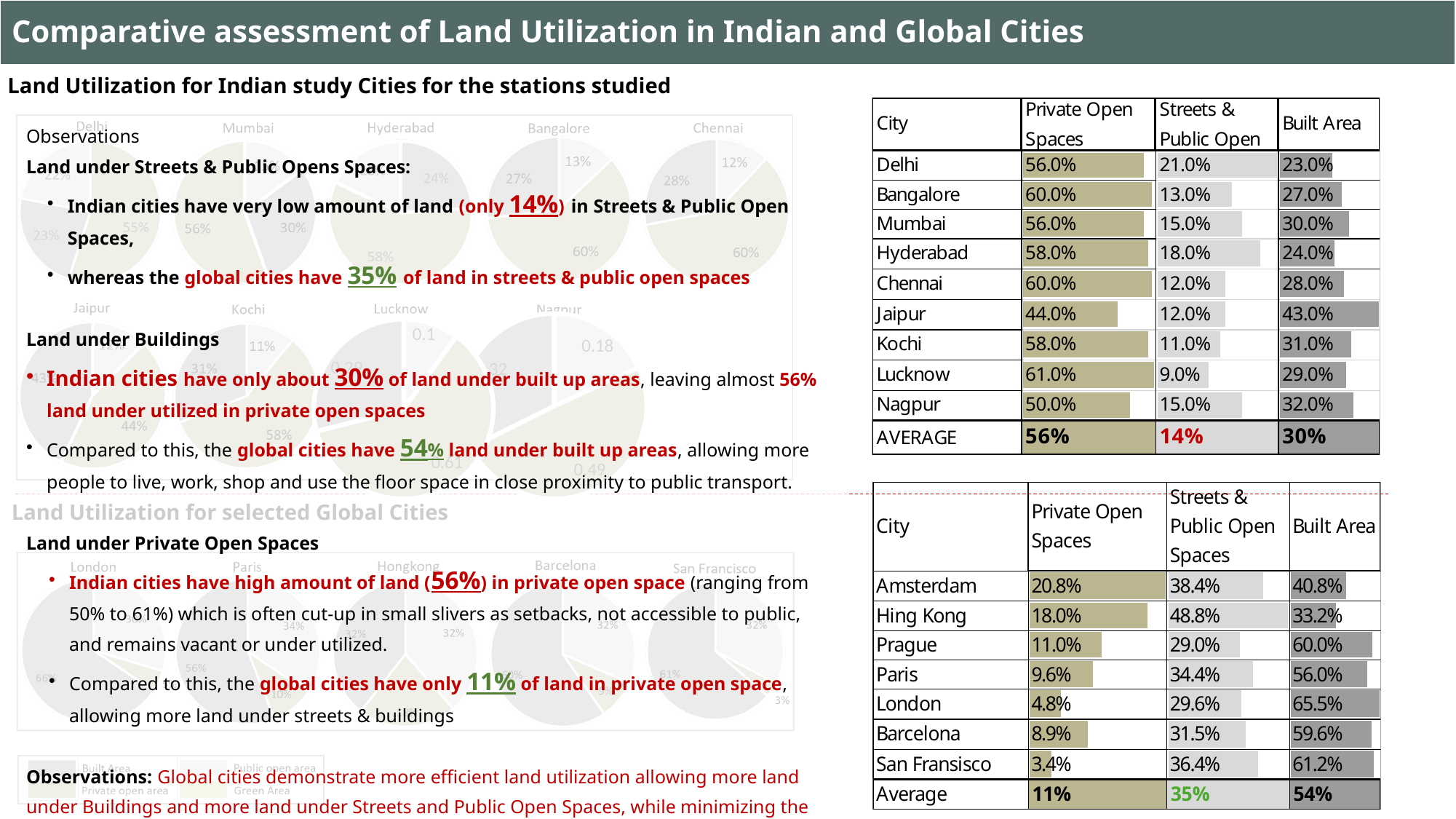
In the global cities table, which city has the highest Streets & Public Open Spaces value? Hing Kong In the Indian cities table, which city has the lowest Streets & Public Open value? Lucknow In the Indian cities table, what is the Private Open Spaces value for Jaipur? 44.0% How many individual cities (excluding the average row) are listed in the Indian cities table? 9 In the Indian cities table, which has a larger Private Open Spaces value, Kochi or Nagpur? Kochi In the Indian cities table, what is the AVERAGE value for Streets & Public Open? 14% In the Indian cities table, which city has the highest Built Area? Jaipur What kind of charts are shown faded behind the text on the left side of the slide? Pie charts In the global cities table, what is the difference in Built Area between Prague and Amsterdam? 19.2 percentage points In the global cities table, which city has the lowest Private Open Spaces value? San Fransisco In the Indian cities table, what is the difference in Built Area between Bangalore and Delhi? 4.0 percentage points In the global cities table, what is the Built Area value for London? 65.5%